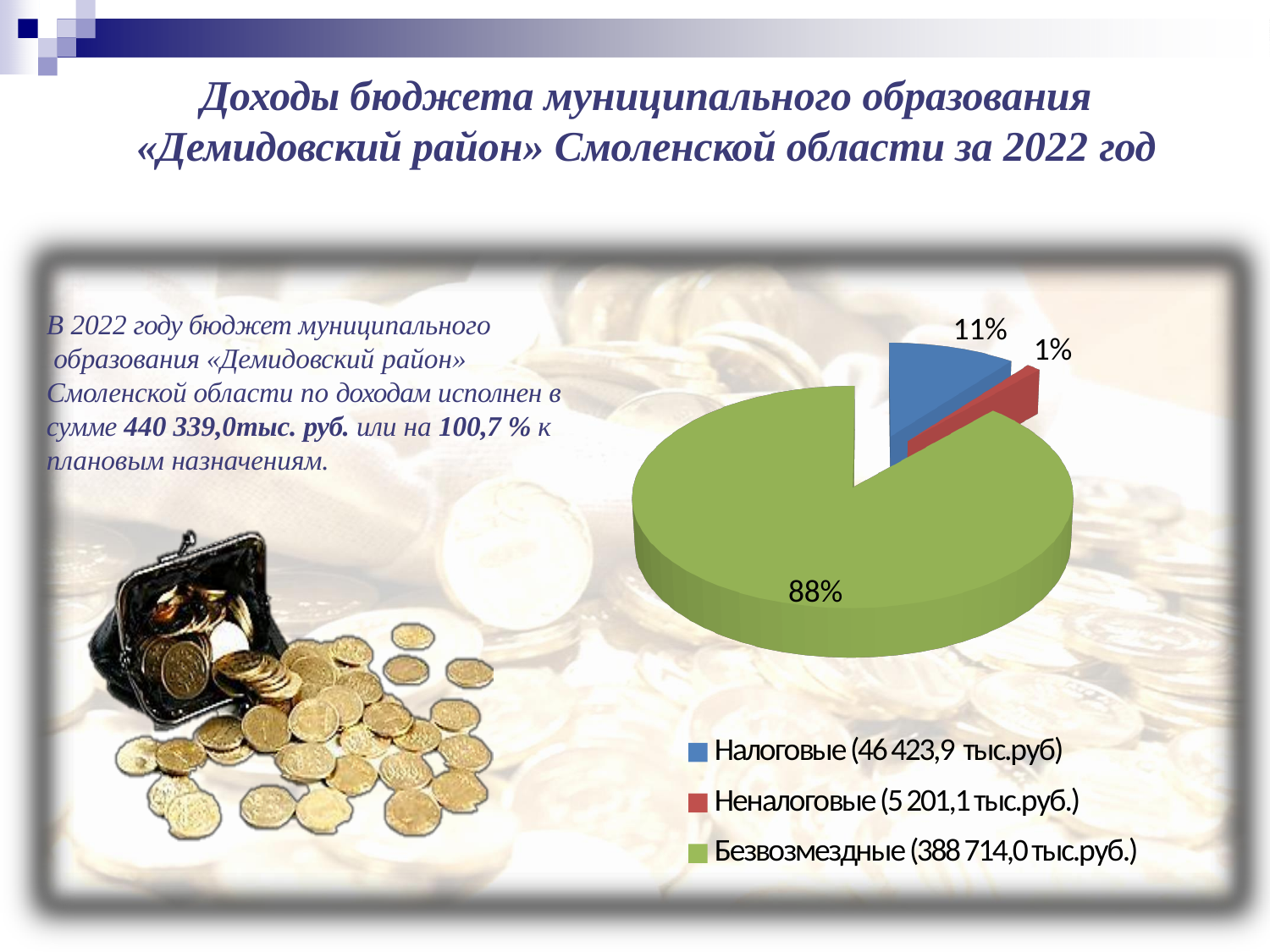
What colour is the Неналоговые slice in the pie chart? red What is the difference in percentage points between the Безвозмездные and Налоговые slices? 77 Which category has the largest slice of the pie? Безвозмездные What share of the pie does the Налоговые slice represent? 11% What share of the pie does the Безвозмездные slice represent? 88% Which slice is larger, Налоговые or Неналоговые? Налоговые What share of the pie does the Неналоговые slice represent? 1% What kind of chart is shown on the slide? pie chart What amount in thousand rubles is shown in the legend for Налоговые? 46 423,9 тыс.руб What amount in thousand rubles is shown in the legend for Безвозмездные? 388 714,0 тыс.руб. Which category has the smallest slice of the pie? Неналоговые How many slices does the pie chart have? 3